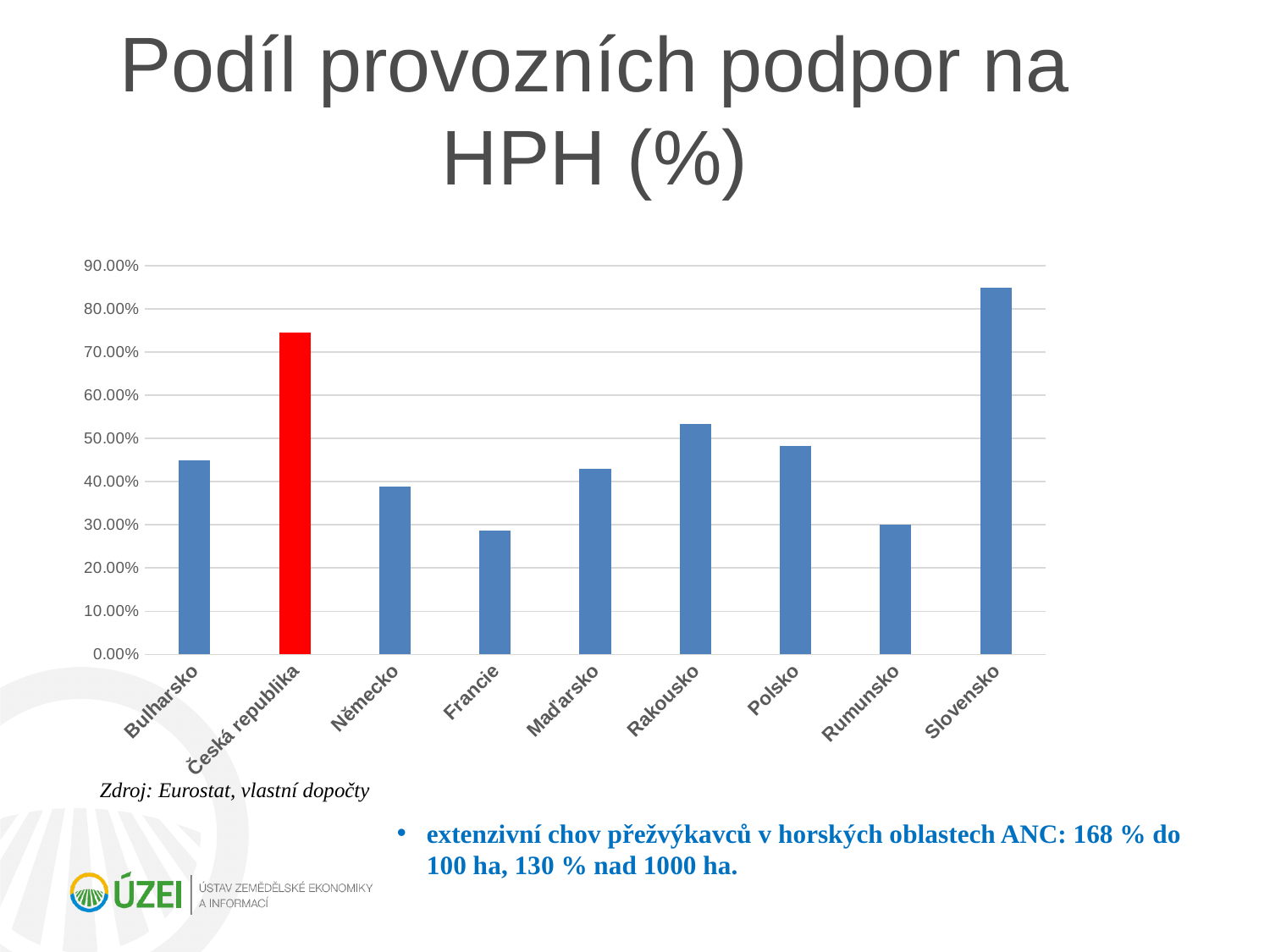
Is the value for Rakousko greater or less than 50.00%? greater Is the value for Slovensko greater or less than 80.00%? greater Which has the larger value, Polsko or Maďarsko? Polsko Is the value for Německo greater or less than 40.00%? less How many countries are shown on the x axis of the chart? 9 Which country has the highest share of operating subsidies on HPH in the chart? Slovensko Which country has the lowest bar in the chart? Francie Which has the larger value, Bulharsko or Rumunsko? Bulharsko Which country's bar is coloured red in the chart? Česká republika What kind of chart is shown on the slide? bar chart